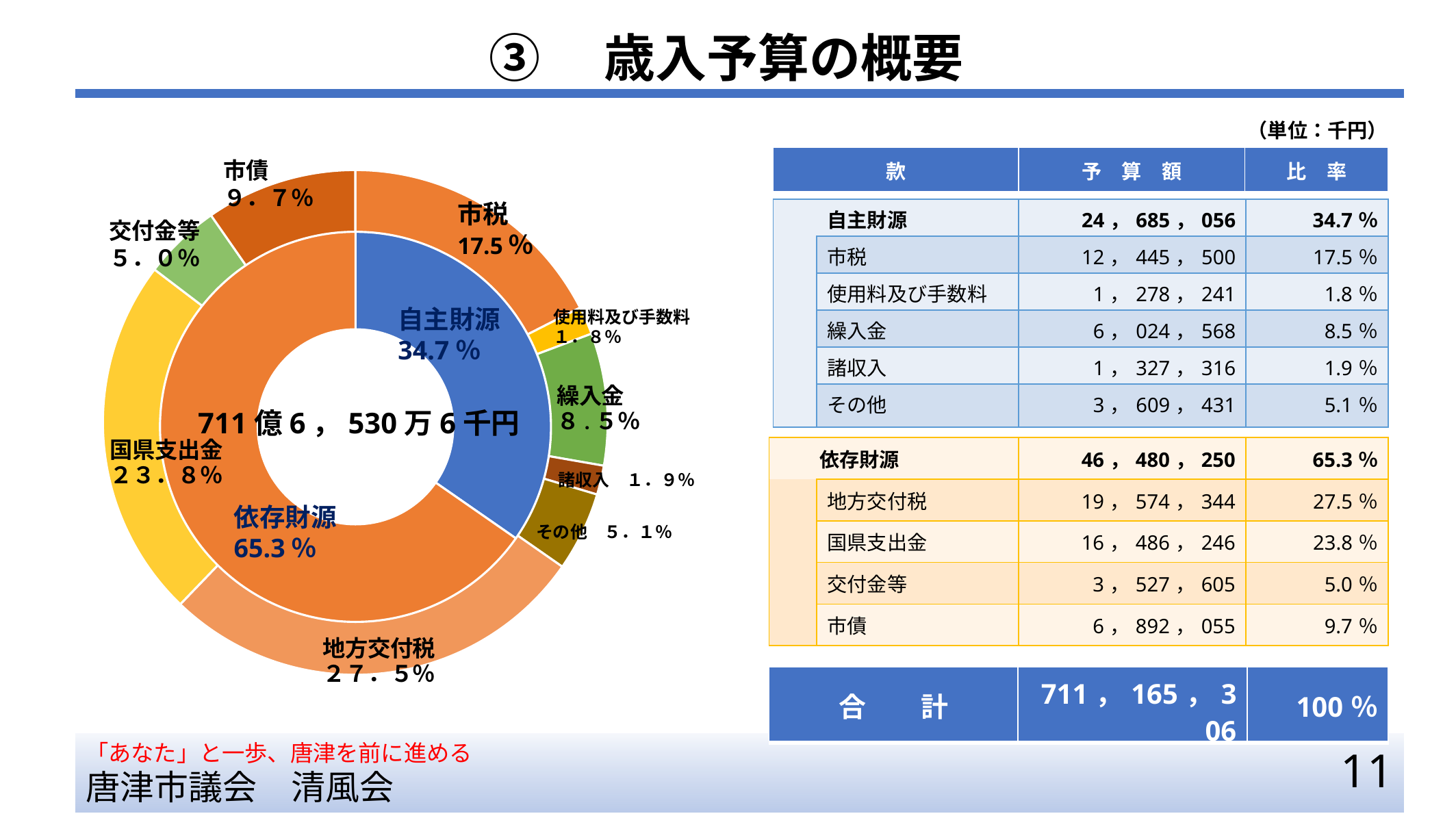
What is the difference in percentage points between 繰入金 and 交付金等 in the outer ring? 3.5 Which category in the outer ring has the smallest share? 使用料及び手数料 What percentage is shown for 市債 in the outer ring? 9.7% How many categories are shown in the outer ring of the doughnut chart? 9 What is the difference in percentage points between 依存財源 and 自主財源 in the inner ring? 30.6 Which is larger in the outer ring, 国県支出金 or 市税? 国県支出金 What percentage is shown for 地方交付税 in the outer ring? 27.5% What percentage does the inner ring show for 依存財源? 65.3% What percentage does the inner ring show for 自主財源? 34.7% What kind of chart is shown on the left of the slide? Doughnut chart What total amount is printed in the centre of the doughnut chart? 711億6,530万6千円 Which category in the outer ring has the largest share? 地方交付税